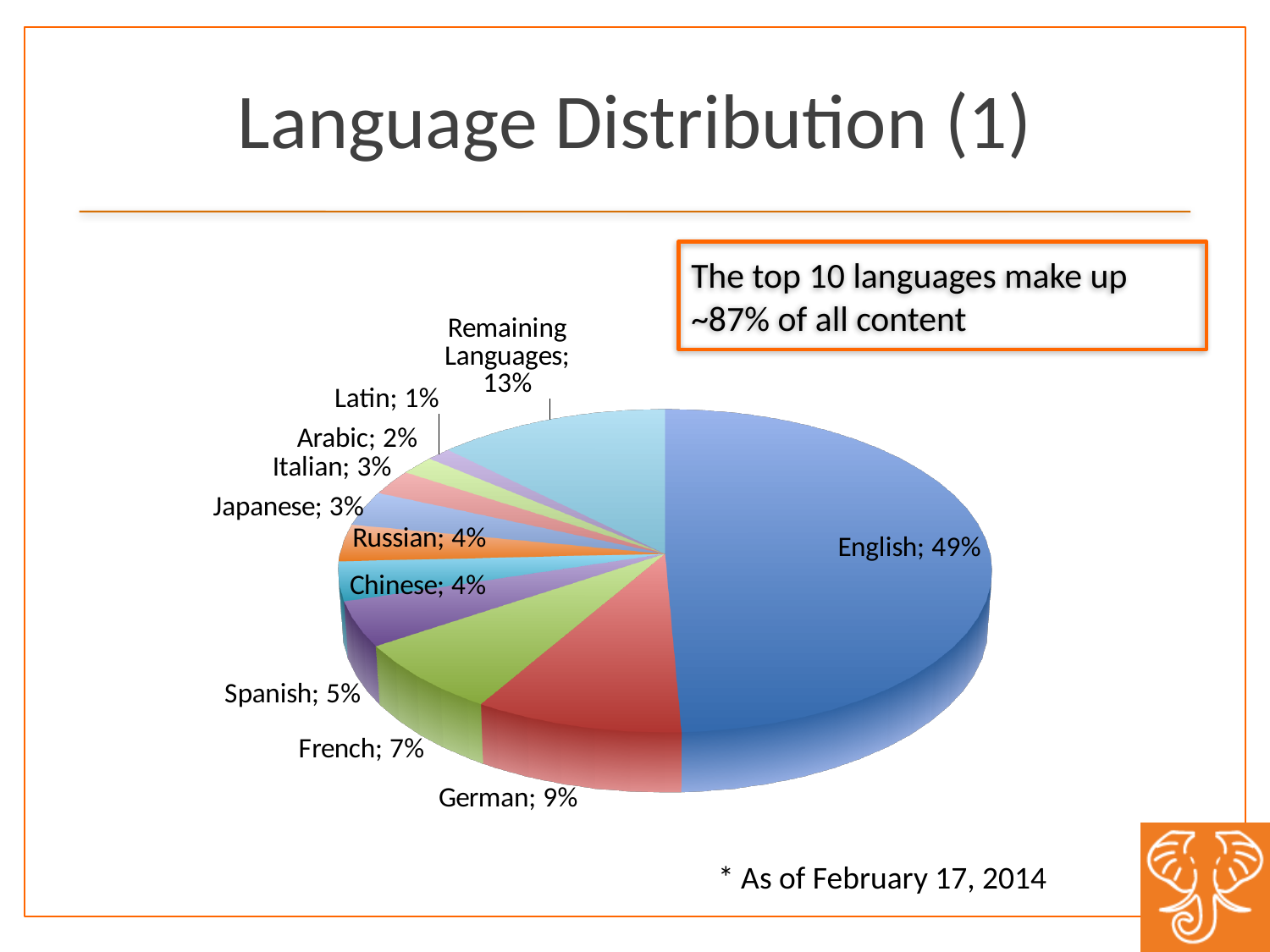
Which named language has the smallest slice of the pie? Latin How many slices does the pie chart have? 11 Which is larger, the share for French or the share for Spanish? French What share of content do the Remaining Languages make up? 13% Which language has the largest slice of the pie? English What share of content is English? 49% What share of content is Spanish? 5% What is the difference in percentage points between English and German? 40 What kind of chart is shown on the slide? Pie chart What share of content is Latin? 1% What share of content is French? 7% What share of content is German? 9%